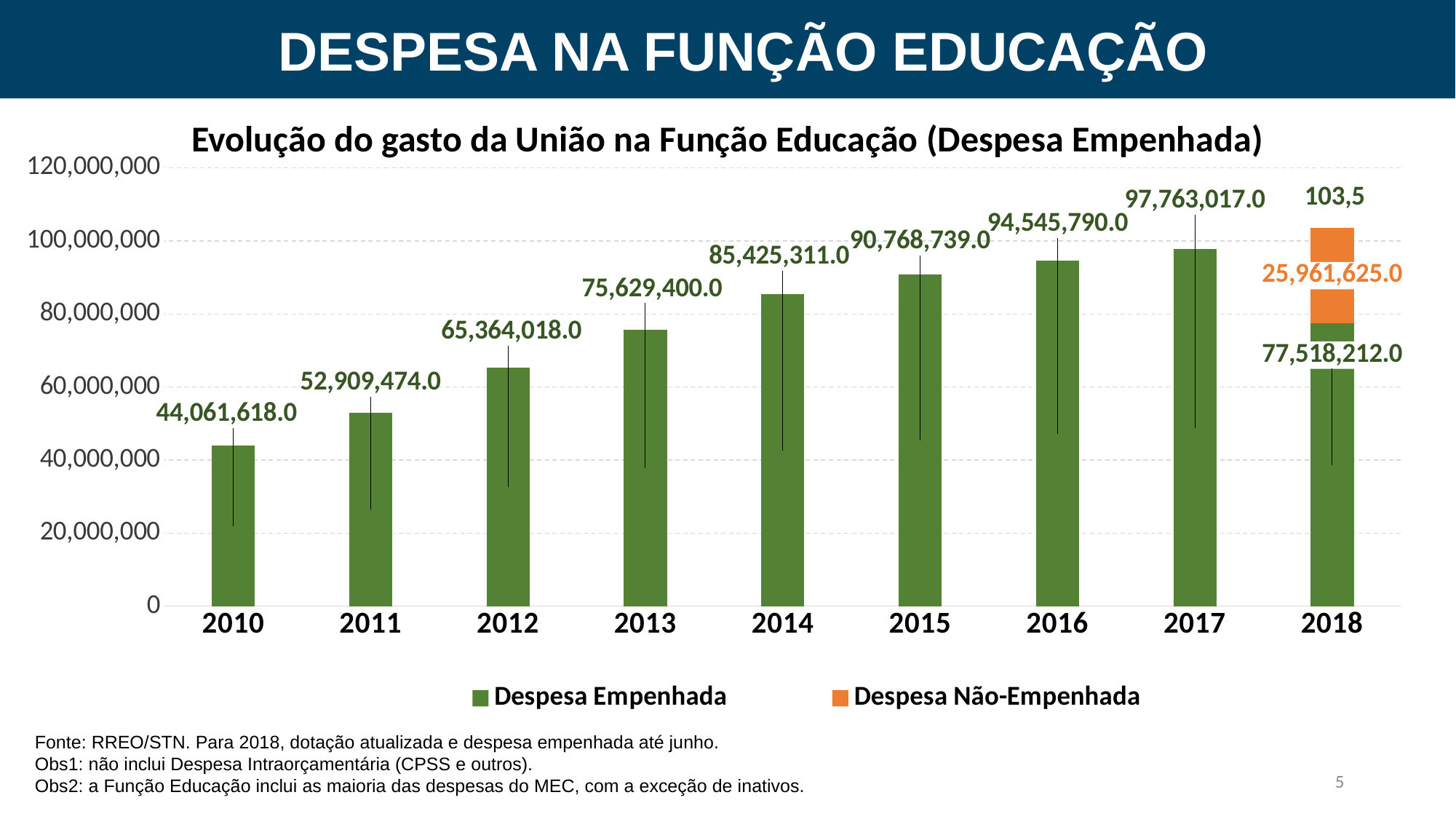
What is the Despesa Empenhada value for 2010? 44,061,618.0 What is the Despesa Não-Empenhada value for 2018? 25,961,625.0 Which year has the highest Despesa Empenhada value? 2017 What type of chart is shown on the slide? Stacked bar chart Is the Despesa Empenhada value for 2014 greater or less than 80,000,000? greater How many years are shown on the x axis? 9 Which is larger, the Despesa Empenhada value for 2015 or for 2016? 2016 What is the Despesa Empenhada value for 2013? 75,629,400.0 What is the difference between the Despesa Empenhada values for 2017 and 2010? 53,701,399.0 Does the Despesa Empenhada value rise or fall from 2010 to 2017? Rises How many series does the legend list? 2 Which year has the lowest Despesa Empenhada value? 2010